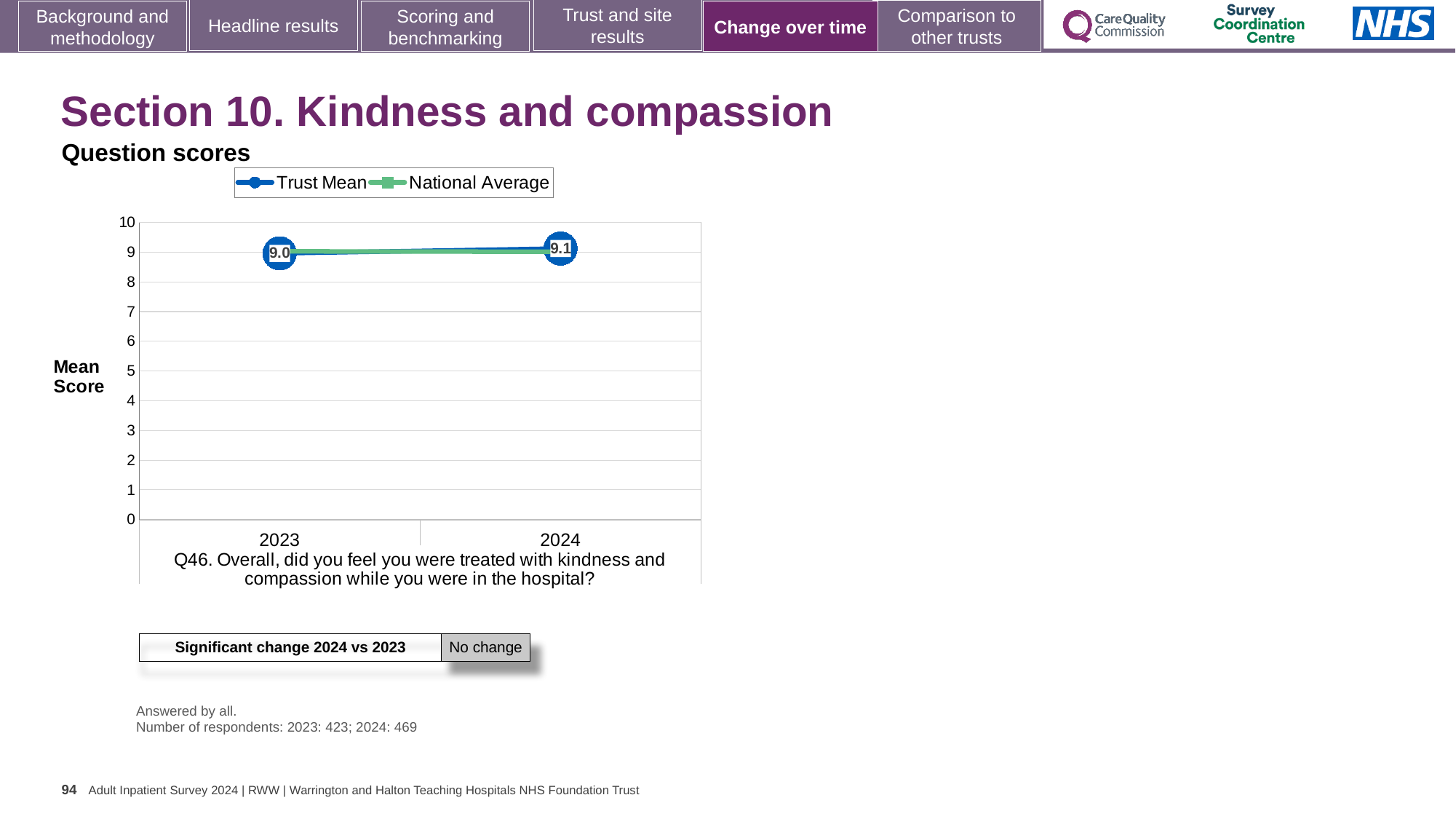
How many series does the chart legend list? 2 How many years are shown on the x axis of the chart? 2 Is the National Average for 2023 greater or less than 8? greater What kind of chart is shown on the slide? line chart Which year has the higher Trust Mean score, 2023 or 2024? 2024 Is the Trust Mean for 2024 greater or less than 5? greater What is the Trust Mean score for 2023? 9.0 What are the two series named in the chart legend? Trust Mean and National Average Does the Trust Mean rise or fall from 2023 to 2024? rise What is the label of the y axis of the chart? Mean Score What is the Trust Mean score for 2024? 9.1 What is the difference between the Trust Mean scores for 2024 and 2023? 0.1